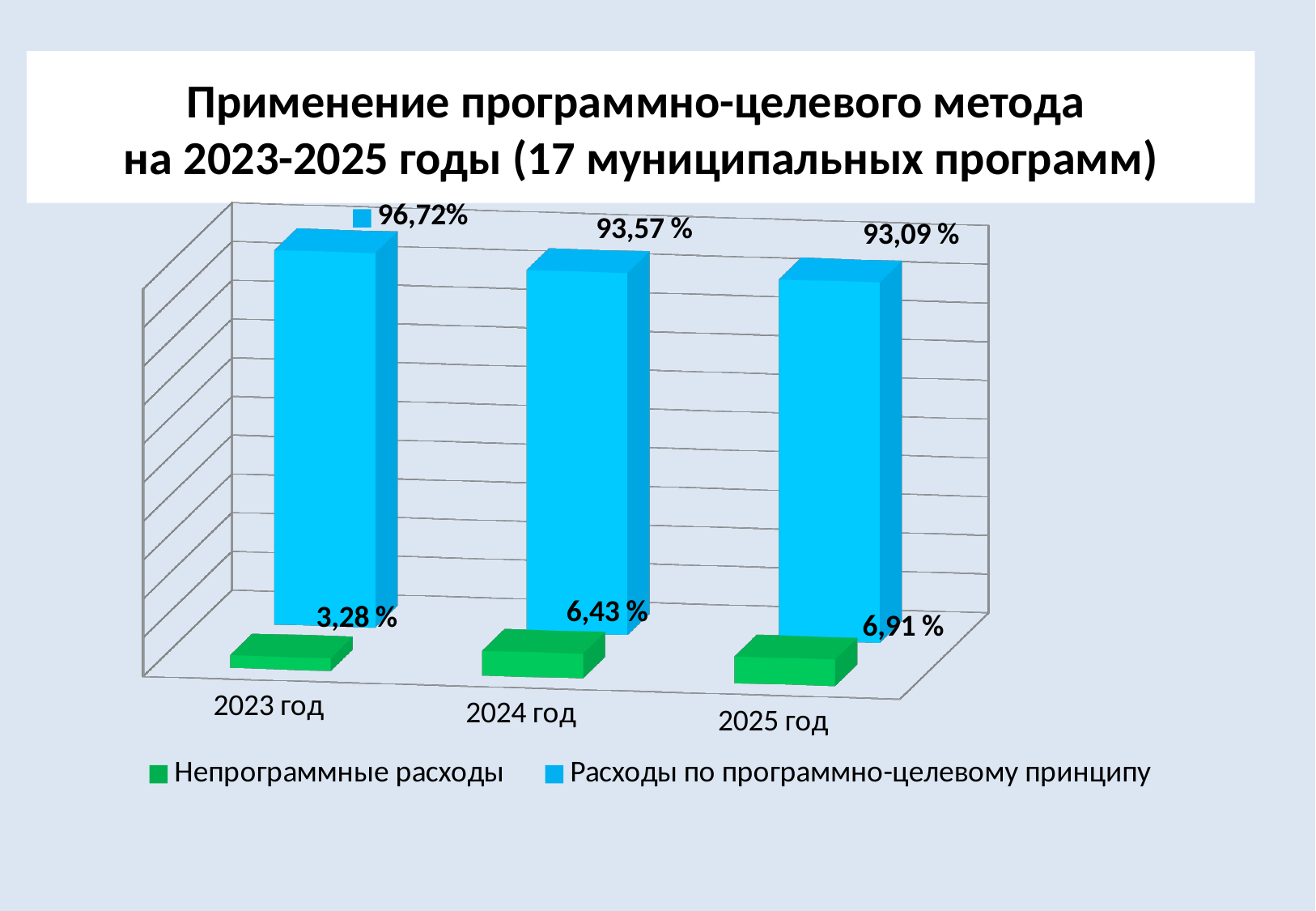
What is the value for Расходы по программно-целевому принципу in 2023 год? 96,72% What is the difference between Расходы по программно-целевому принципу in 2023 год and 2024 год? 3,15 % In which year is Расходы по программно-целевому принципу highest? 2023 год In which year is Непрограммные расходы lowest? 2023 год What is the value for Расходы по программно-целевому принципу in 2024 год? 93,57 % Which is larger: Непрограммные расходы in 2024 год or in 2025 год? 2025 год How many series does the legend list? 2 How many years are shown on the x axis? 3 Does Непрограммные расходы rise or fall from 2023 год to 2025 год? Rise What is the value for Непрограммные расходы in 2025 год? 6,91 % What is the value for Непрограммные расходы in 2024 год? 6,43 % What kind of chart is shown on the slide? Bar chart